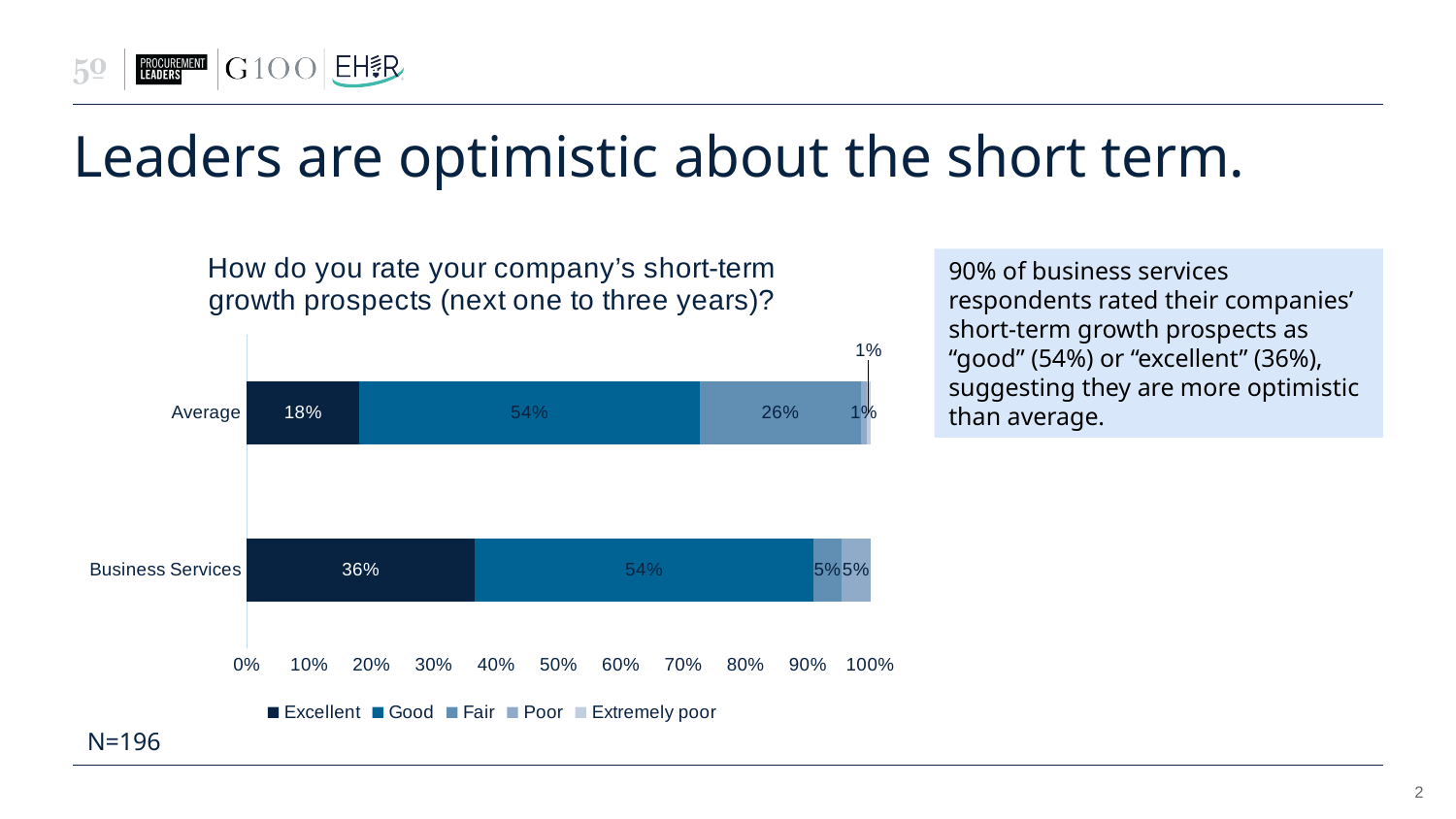
What percentage of Average respondents rated their short-term growth prospects as Excellent? 18% What is the Fair value for the Average bar? 26% Which category has the larger Excellent share, Average or Business Services? Business Services What is the Good value for Business Services? 54% What is the title of the chart? How do you rate your company's short-term growth prospects (next one to three years)? What percentage of Business Services respondents rated their short-term growth prospects as Excellent? 36% What kind of chart is shown on the slide? Stacked bar chart How many series does the legend list? 5 What is the Good value for the Average bar? 54% What is the combined Excellent and Good share for Business Services? 90% How many categories are shown on the chart? 2 How many percentage points higher is the Excellent share for Business Services than for Average? 18 percentage points